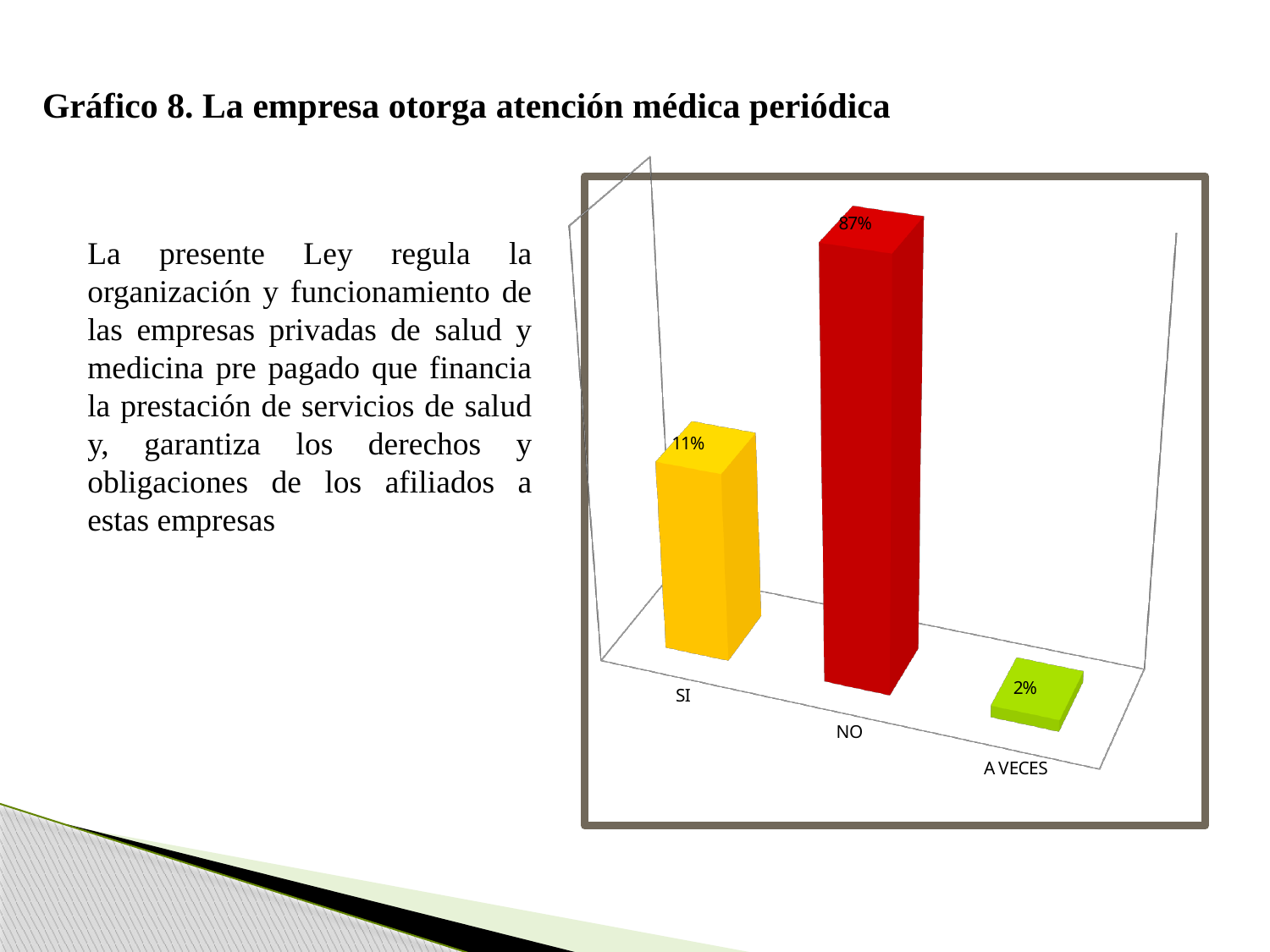
Which category has the highest value? NO What is the value for SI? 11% What is the difference between the values for NO and SI? 76% How many categories are shown in the chart? 3 Which is larger, the value for SI or the value for A VECES? SI What is the title of the chart on the slide? Gráfico 8. La empresa otorga atención médica periódica Which category has the lowest value? A VECES What is the value for NO? 87% What is the value for A VECES? 2% What colour is the bar for NO? red What is the difference between the values for SI and A VECES? 9% What kind of chart is shown on the slide? bar chart